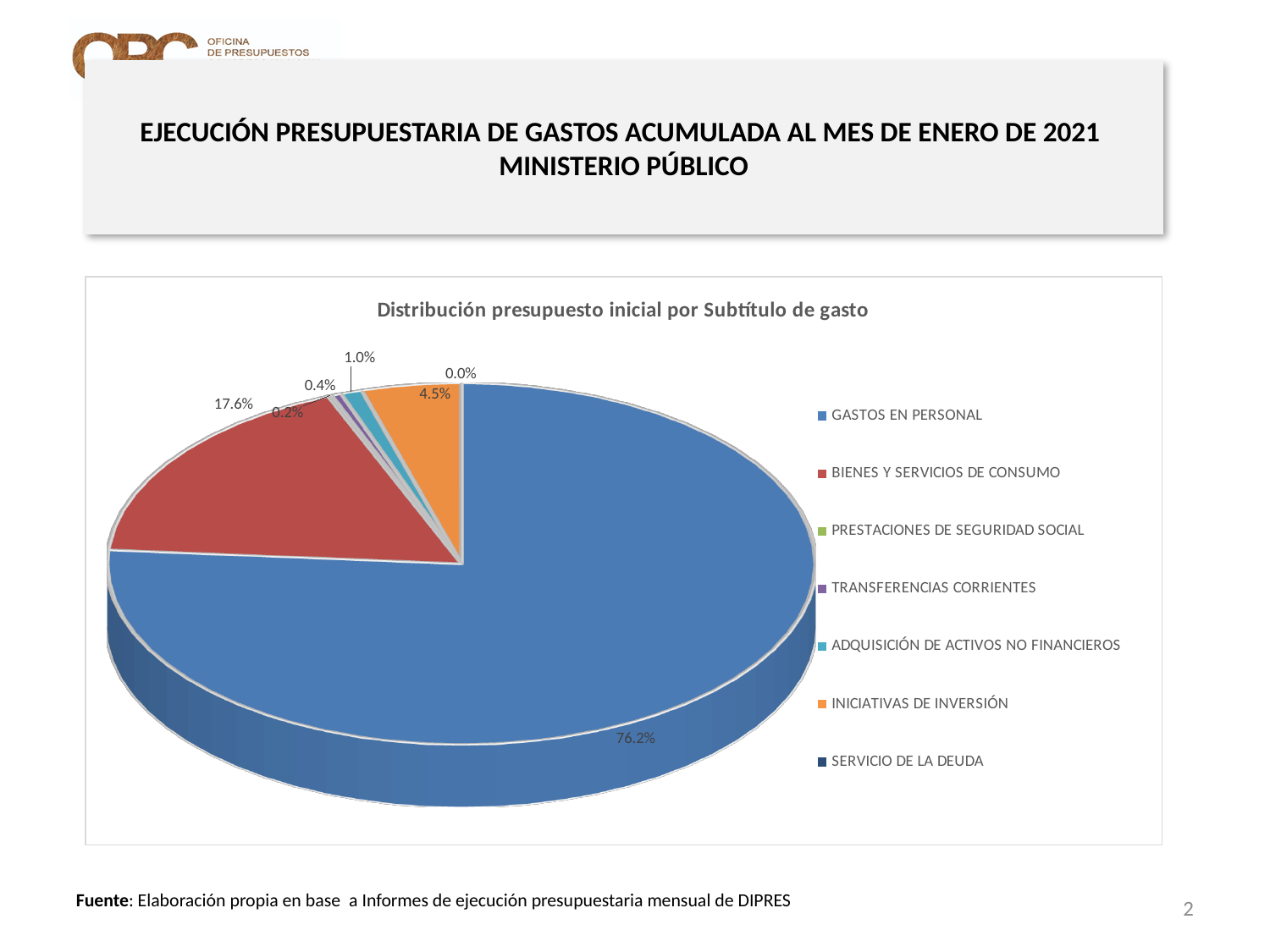
Which category has the smallest share of the pie? SERVICIO DE LA DEUDA Which category has the largest share of the pie? GASTOS EN PERSONAL What share of the pie does GASTOS EN PERSONAL represent? 76.2% What share of the pie does INICIATIVAS DE INVERSIÓN represent? 4.5% What share of the pie does BIENES Y SERVICIOS DE CONSUMO represent? 17.6% What is the difference in percentage points between GASTOS EN PERSONAL and BIENES Y SERVICIOS DE CONSUMO? 58.6 What kind of chart is shown on the slide? pie chart What share of the pie does ADQUISICIÓN DE ACTIVOS NO FINANCIEROS represent? 1.0% What share of the pie does SERVICIO DE LA DEUDA represent? 0.0% What is the title of the chart? Distribución presupuesto inicial por Subtítulo de gasto Which is larger, the share for INICIATIVAS DE INVERSIÓN or the share for ADQUISICIÓN DE ACTIVOS NO FINANCIEROS? INICIATIVAS DE INVERSIÓN How many categories does the legend of the pie chart list? 7